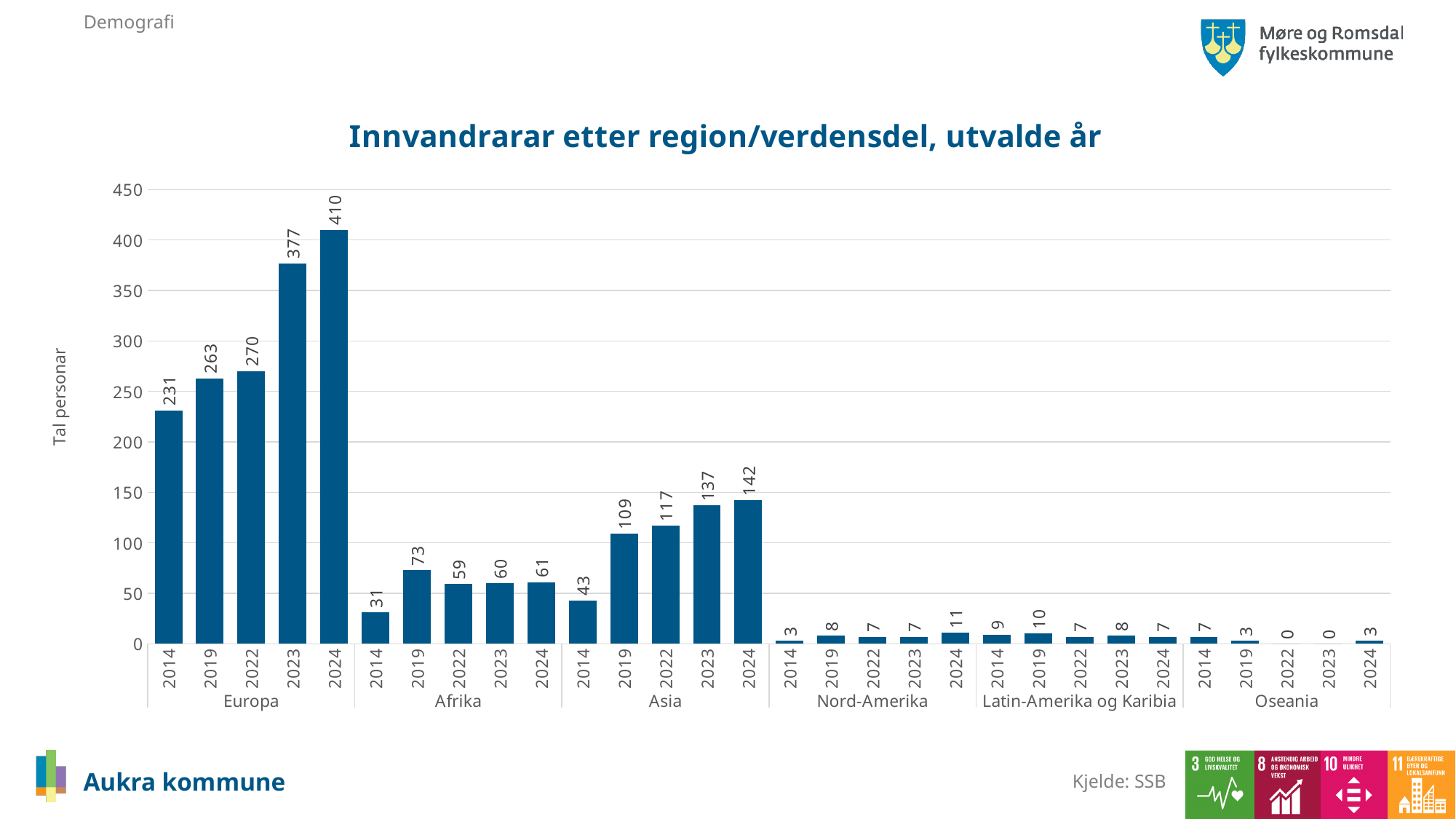
What is the lowest value shown for Oseania? 0 What is the difference between the Europa values for 2024 and 2014? 179 Is the value for Europa in 2023 greater or less than 350? greater How many regions are shown on the x axis? 6 What kind of chart is this? Bar chart Which region has the highest bar on the chart? Europa What is the value for Nord-Amerika in 2024? 11 What is the value for Asia in 2014? 43 Which is larger: Asia in 2023 or Afrika in 2023? Asia in 2023 Do the values for Asia rise or fall from 2014 to 2024? Rise What is the value for Afrika in 2019? 73 What is the value for Europa in 2024? 410